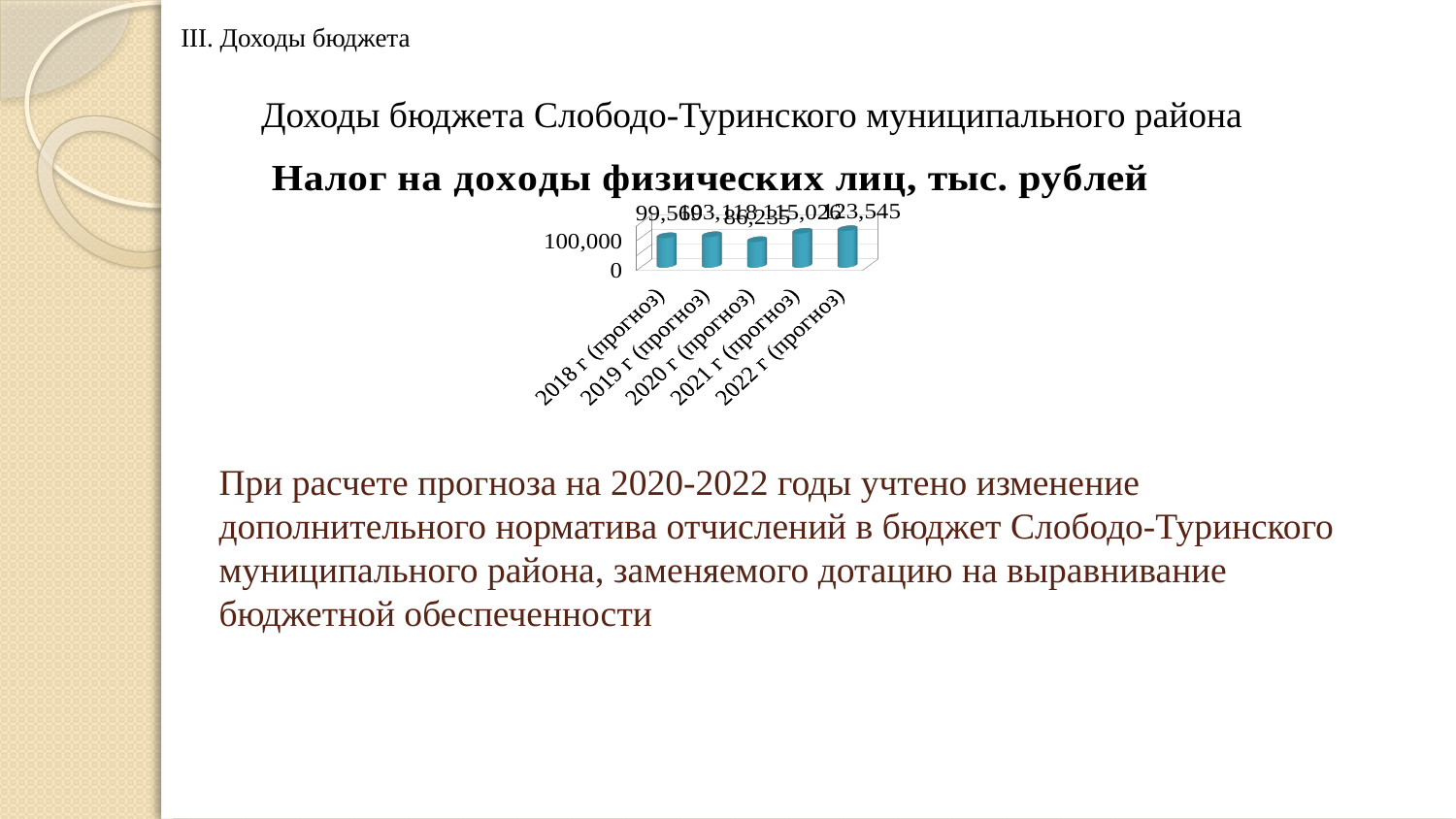
Is the value for 2022 г (прогноз) greater or less than 100,000? greater What kind of chart is shown on the slide? bar chart What is the value for 2022 г (прогноз)? 123,545 Is the value for 2020 г (прогноз) greater or less than 100,000? less What is the value for 2020 г (прогноз)? 86,235 How many categories (years) are plotted in the chart? 5 What is the difference between the values for 2022 г (прогноз) and 2020 г (прогноз)? 37,310 Which year has the highest value in the chart? 2022 г (прогноз) Which year has the lowest value in the chart? 2020 г (прогноз) Which is larger, the value for 2020 г (прогноз) or 2021 г (прогноз)? 2021 г (прогноз) What is the title of the chart? Налог на доходы физических лиц, тыс. рублей What colour are the bars in the chart? blue (teal)